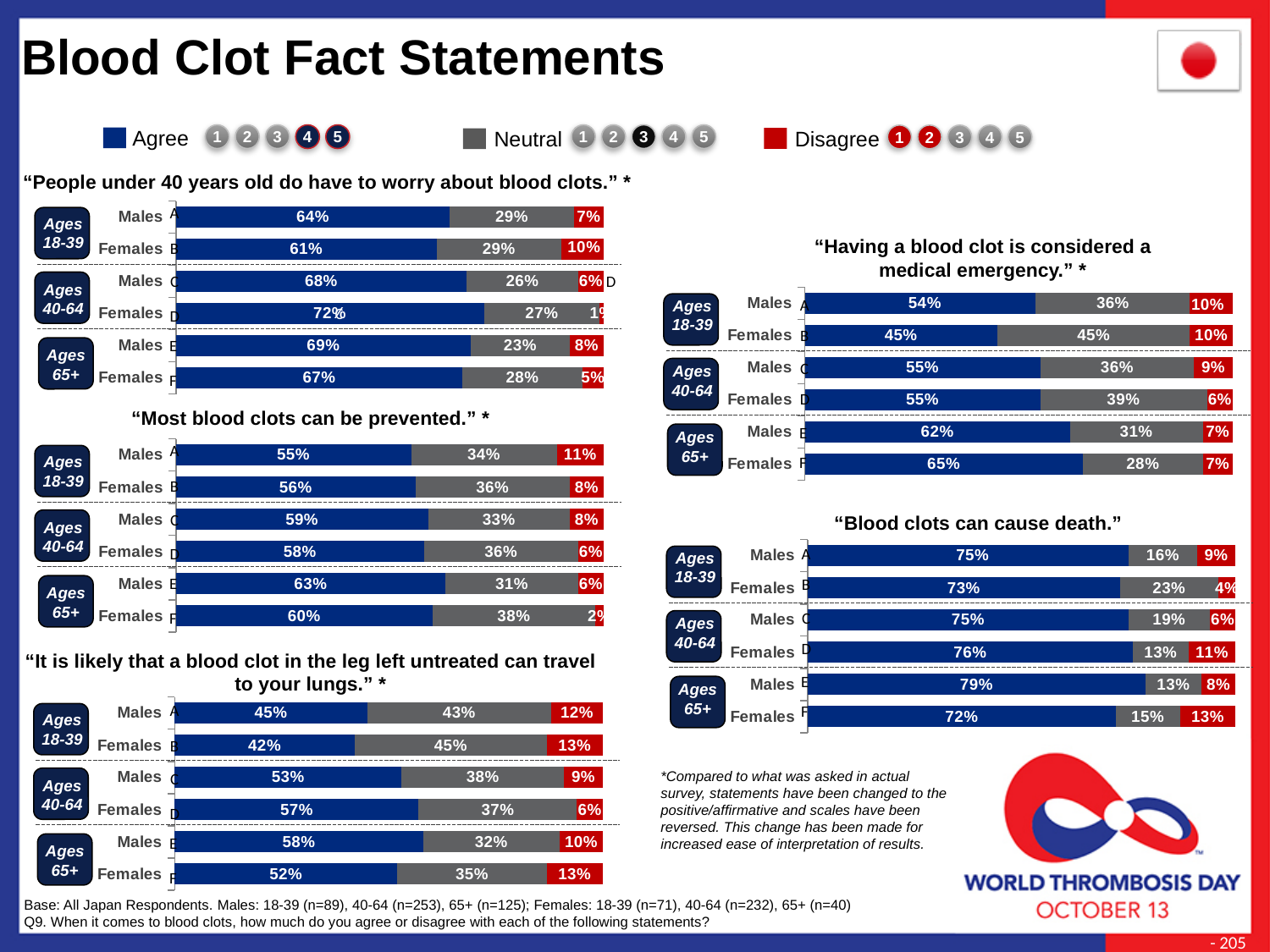
Which colour represents Disagree in the legend? Red How many series does the legend at the top of the slide list? 3 In the "Blood clots can cause death." chart, which is larger: the Disagree percentage for Females 65+ or for Males 65+? Females 65+ In the "People under 40 years old do have to worry about blood clots." chart, which group has the lowest Agree percentage? Females 18-39 In the "Having a blood clot is considered a medical emergency." chart, what percentage of Females 18-39 are neutral? 45% In the "It is likely that a blood clot in the leg left untreated can travel to your lungs." chart, which group has the highest Agree percentage? Males 65+ In the "It is likely that a blood clot in the leg left untreated can travel to your lungs." chart, what is the Neutral percentage for Males 40-64? 38% In the "Blood clots can cause death." chart, what percentage of Males 65+ agree? 79% How many groups (bars) are shown in the "Most blood clots can be prevented." chart? 6 What type of chart is used for "Blood clots can cause death."? Stacked bar chart In the "Most blood clots can be prevented." chart, what percentage of Males 18-39 disagree? 11% In the "Having a blood clot is considered a medical emergency." chart, what is the difference between the Agree percentages for Females 65+ and Females 18-39? 20 percentage points